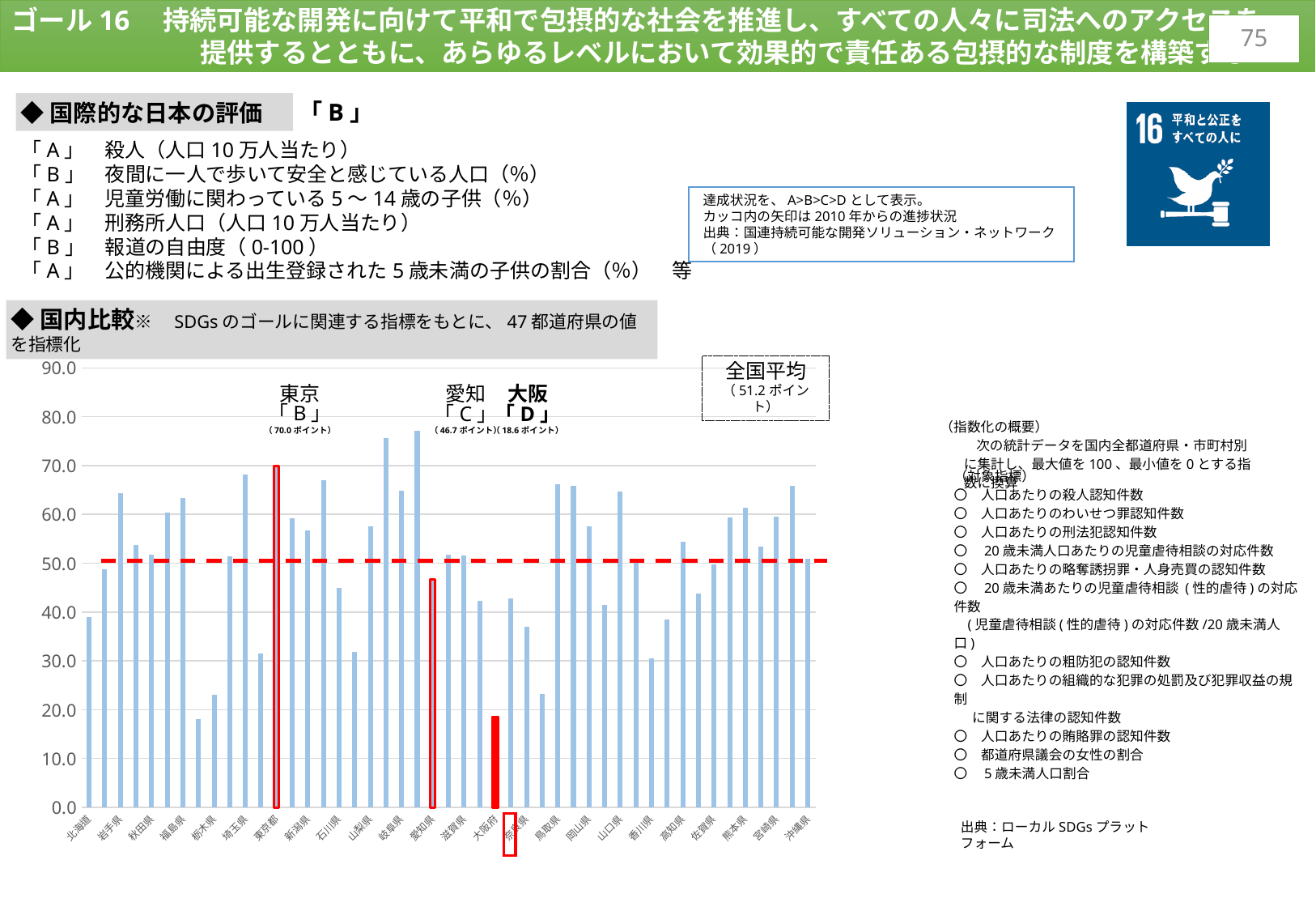
What is the difference between the values for 東京 and 愛知 on the chart? 23.3 ポイント What is the 全国平均 value shown on the chart? 51.2 ポイント What is the value shown for 大阪 in the 国内比較 bar chart? 18.6 ポイント What kind of chart is used for the 国内比較 section? bar chart What grade is shown above the 大阪 bar on the chart? 「D」 Is the value for 岡山県 greater or less than 60.0? less Is the value for 栃木県 greater or less than 30.0? less What is the value shown for 東京 in the 国内比較 bar chart? 70.0 ポイント Which has the larger value on the chart, 東京 or 愛知? 東京 Which has the larger value on the chart, 愛知 or 大阪? 愛知 What is the difference between the values for 東京 and 大阪 on the chart? 51.4 ポイント What is the value shown for 愛知 in the 国内比較 bar chart? 46.7 ポイント